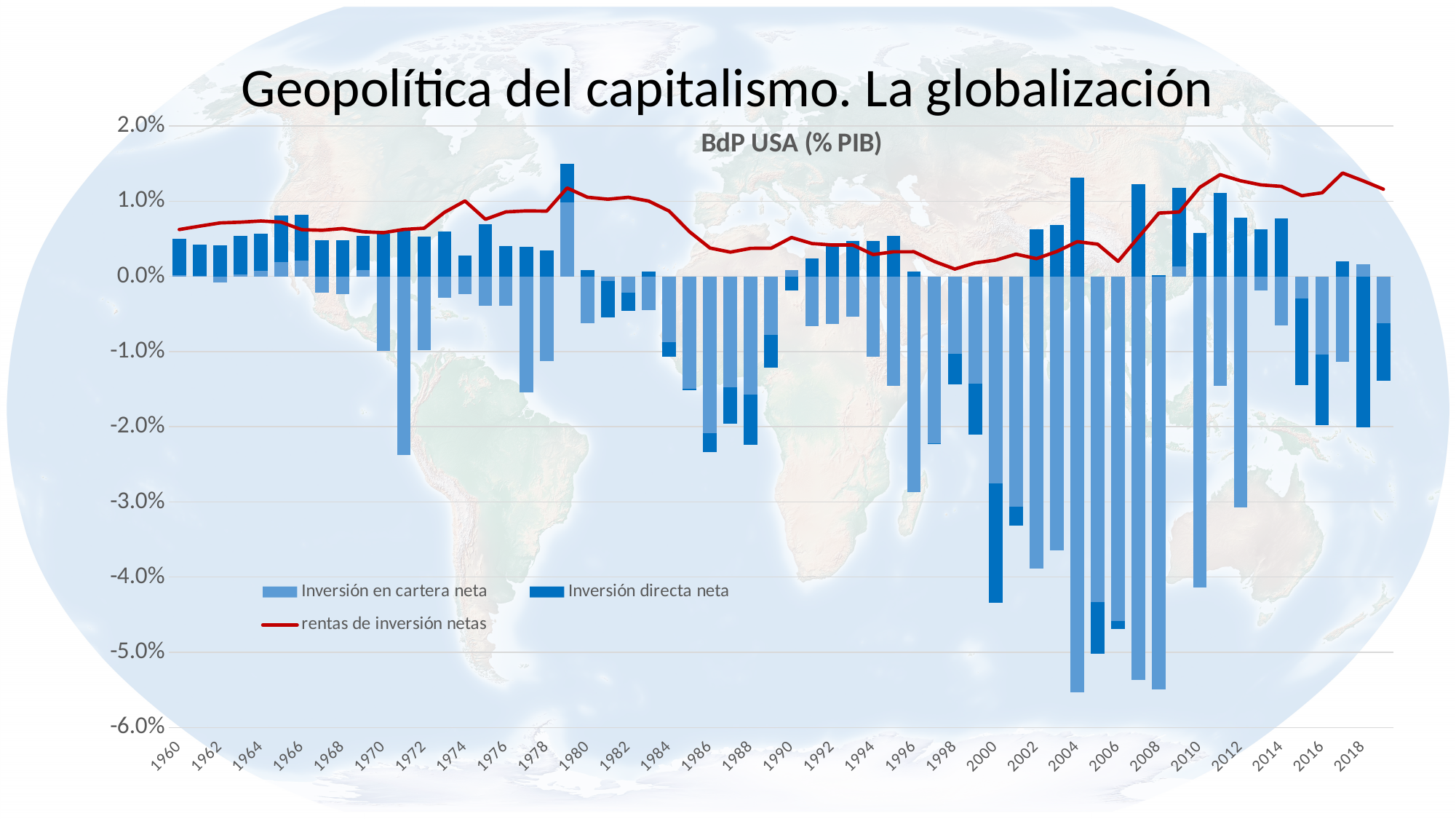
Is the value of rentas de inversión netas in 1985 greater or less than 1.0%? less What is the title of the chart? BdP USA (% PIB) Is the value of Inversión directa neta in 1979 greater or less than 1.0%? less What colour is the rentas de inversión netas line? Red How many series does the legend list? 3 Is the value of Inversión en cartera neta in 2000 greater or less than -2.0%? less Which year has the higher value of rentas de inversión netas, 1998 or 2012? 2012 Does the rentas de inversión netas line rise or fall between 1998 and 2012? rise What kind of chart is this? Bar chart with a line